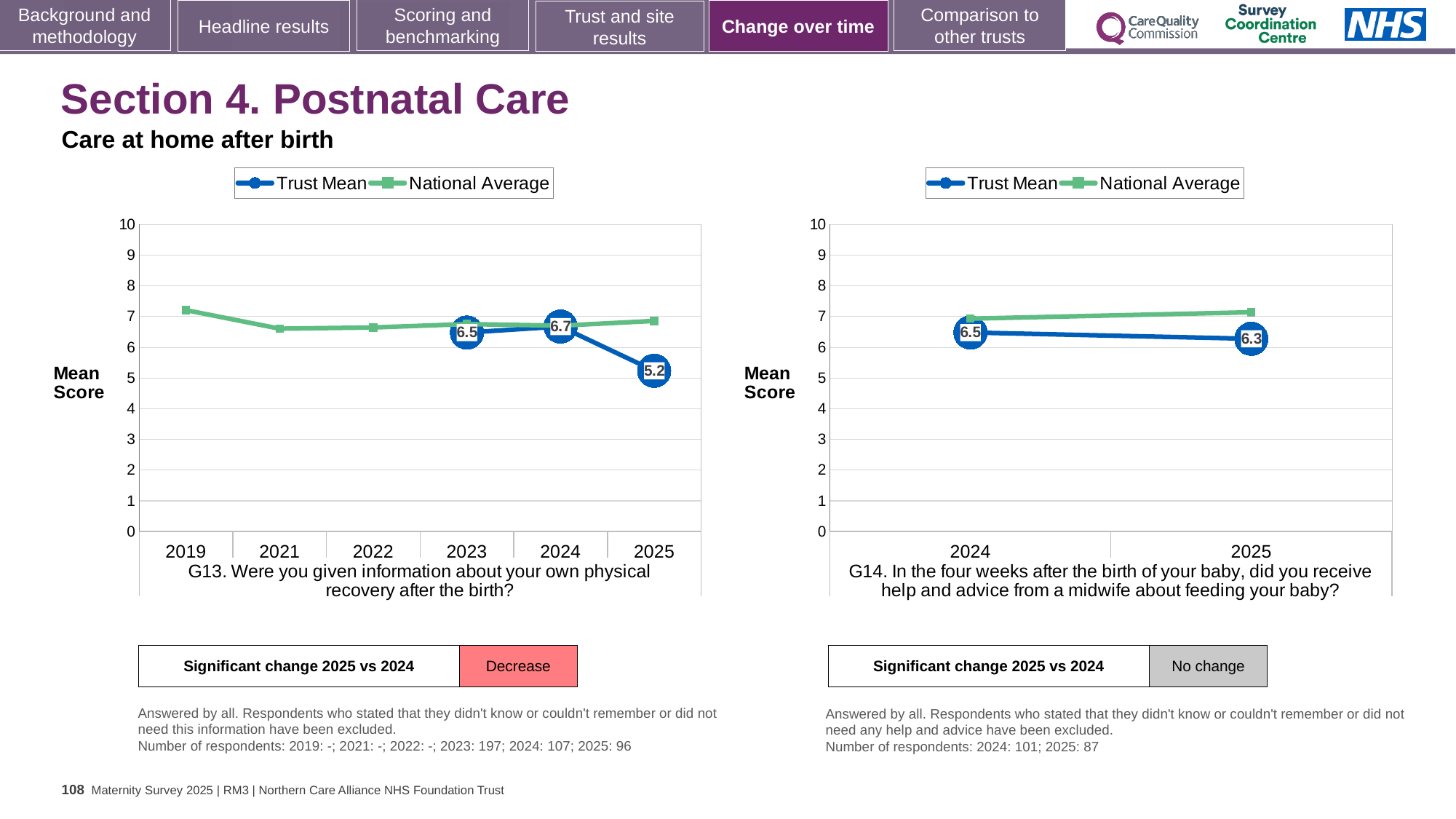
In the G14 chart on the right, what is the Trust Mean value for 2024? 6.5 How many years are shown on the x axis of the G13 chart on the left? 6 In the G13 chart on the left, is the National Average value for 2021 greater or less than 7? less In the G13 chart on the left, which year has the lowest Trust Mean value? 2025 In the G13 chart on the left, what is the difference between the Trust Mean for 2024 and the Trust Mean for 2025? 1.5 What kind of chart is the G14 chart on the right? Line chart In the G13 chart on the left, what is the Trust Mean value for 2023? 6.5 How many series does the legend of the G14 chart on the right list? 2 In the G13 chart on the left, what is the Trust Mean value for 2025? 5.2 In the G14 chart on the right, is the Trust Mean higher in 2024 or in 2025? 2024 In the G13 chart on the left, which year has the highest Trust Mean value? 2024 In the G14 chart on the right, what is the Trust Mean value for 2025? 6.3